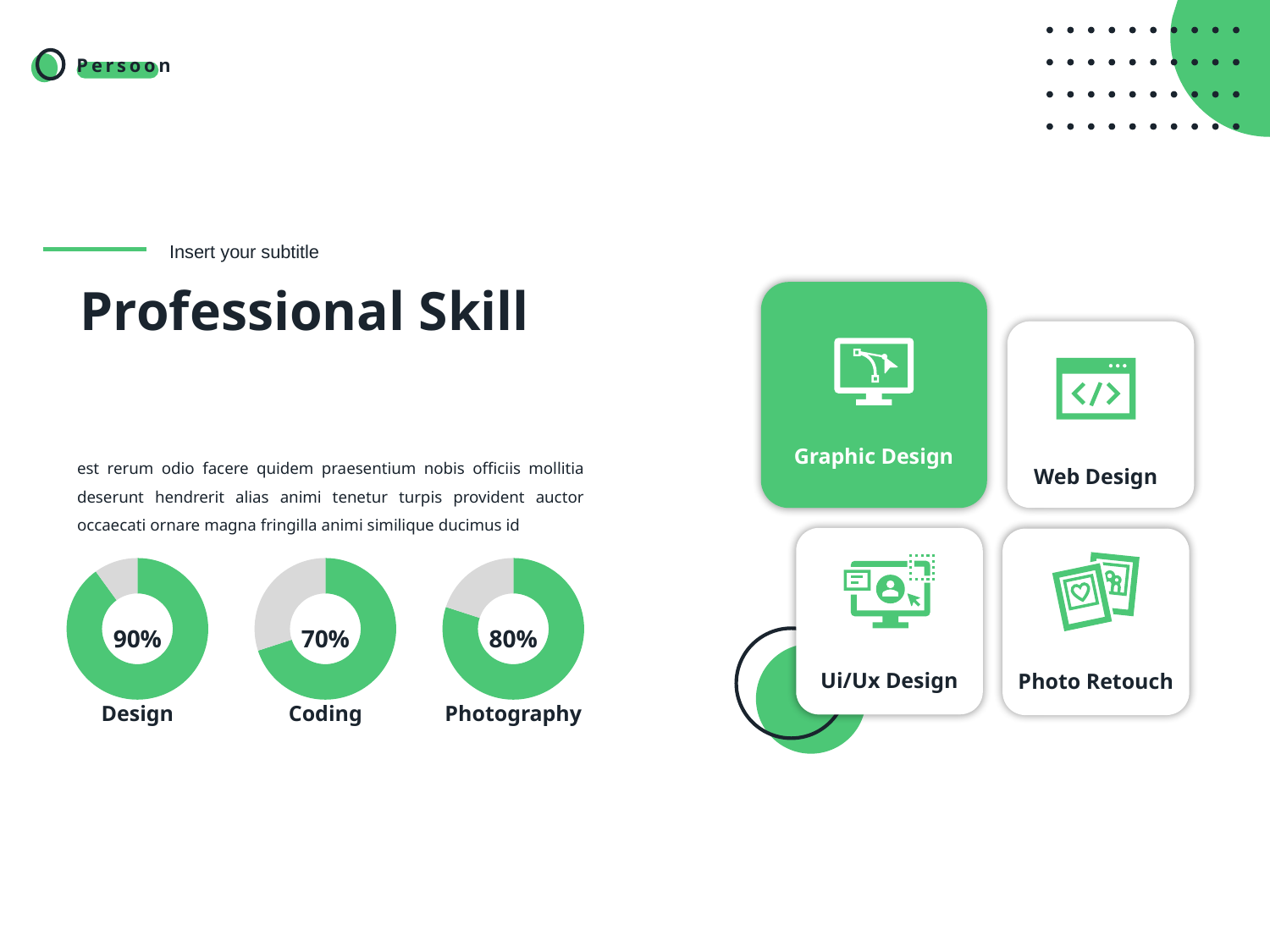
Which is larger, the Design value or the Photography value? Design Which of the three donut charts shows the lowest percentage? Coding What is the difference between the Design and Coding percentages? 20% Which is larger, the Photography value or the Coding value? Photography What is the difference between the Photography and Coding percentages? 10% What colour is the filled portion of the donut charts? Green What kind of chart is used to show the skill percentages? Donut chart What value is shown in the Coding donut chart? 70% Which of the three donut charts shows the highest percentage? Design How many donut charts are shown on the slide? 3 What value is shown in the Design donut chart? 90% What value is shown in the Photography donut chart? 80%